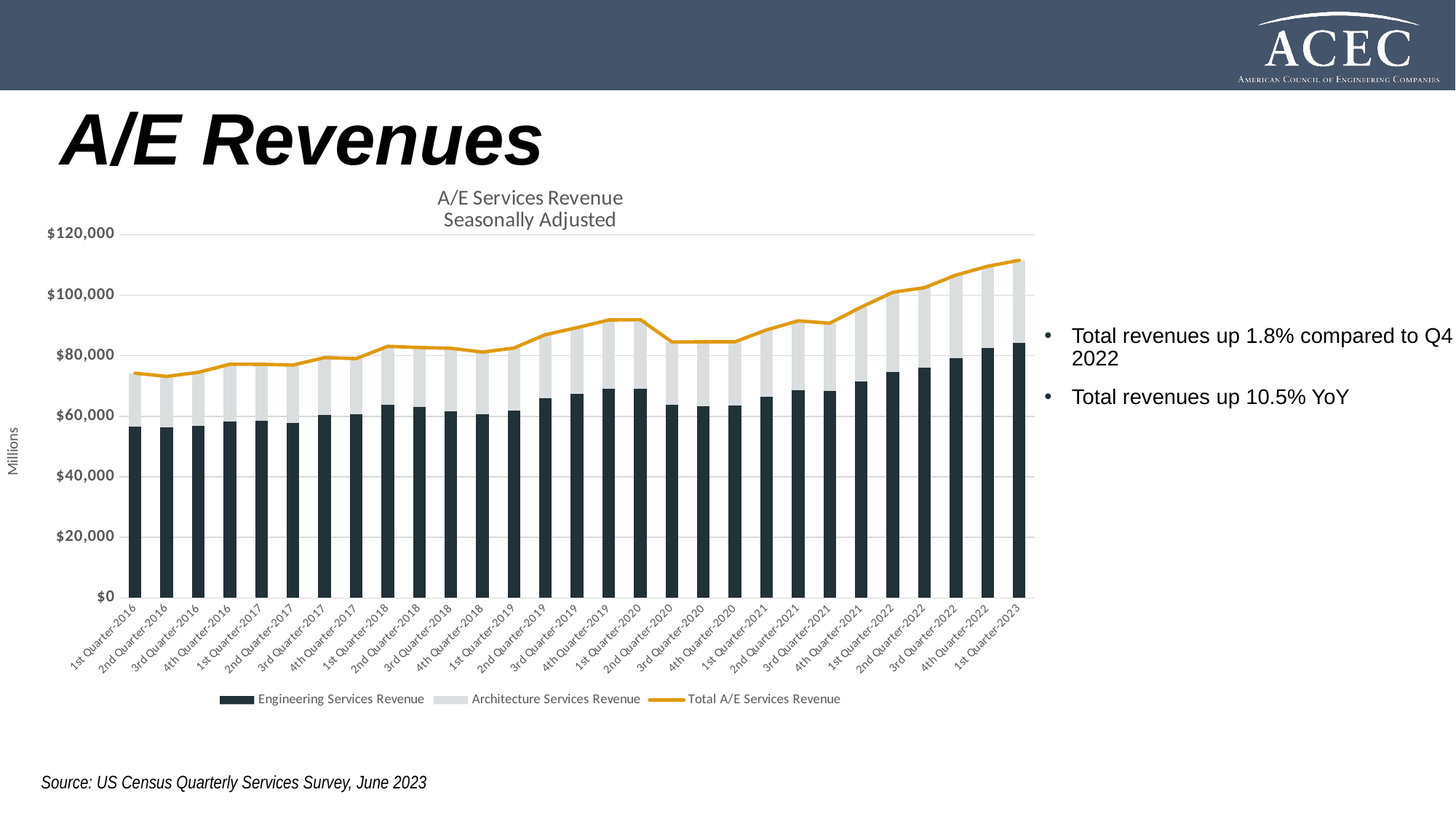
Is the Total A/E Services Revenue for 1st Quarter-2023 greater or less than $100,000? greater Which quarter has the highest Total A/E Services Revenue? 1st Quarter-2023 How many quarters are plotted along the x axis of the chart? 29 How many series does the chart legend list? 3 Which is larger, the Engineering Services Revenue for 1st Quarter-2019 or for 1st Quarter-2022? 1st Quarter-2022 Does the Total A/E Services Revenue generally rise or fall from 1st Quarter-2016 to 1st Quarter-2023? rise Is the Total A/E Services Revenue for 1st Quarter-2016 greater or less than $80,000? less Which is larger, the Total A/E Services Revenue for 1st Quarter-2020 or for 2nd Quarter-2020? 1st Quarter-2020 What kind of chart is shown on the slide? combination bar and line chart Is the Engineering Services Revenue for 1st Quarter-2016 greater or less than $60,000? less What is the title of the chart? A/E Services Revenue Seasonally Adjusted